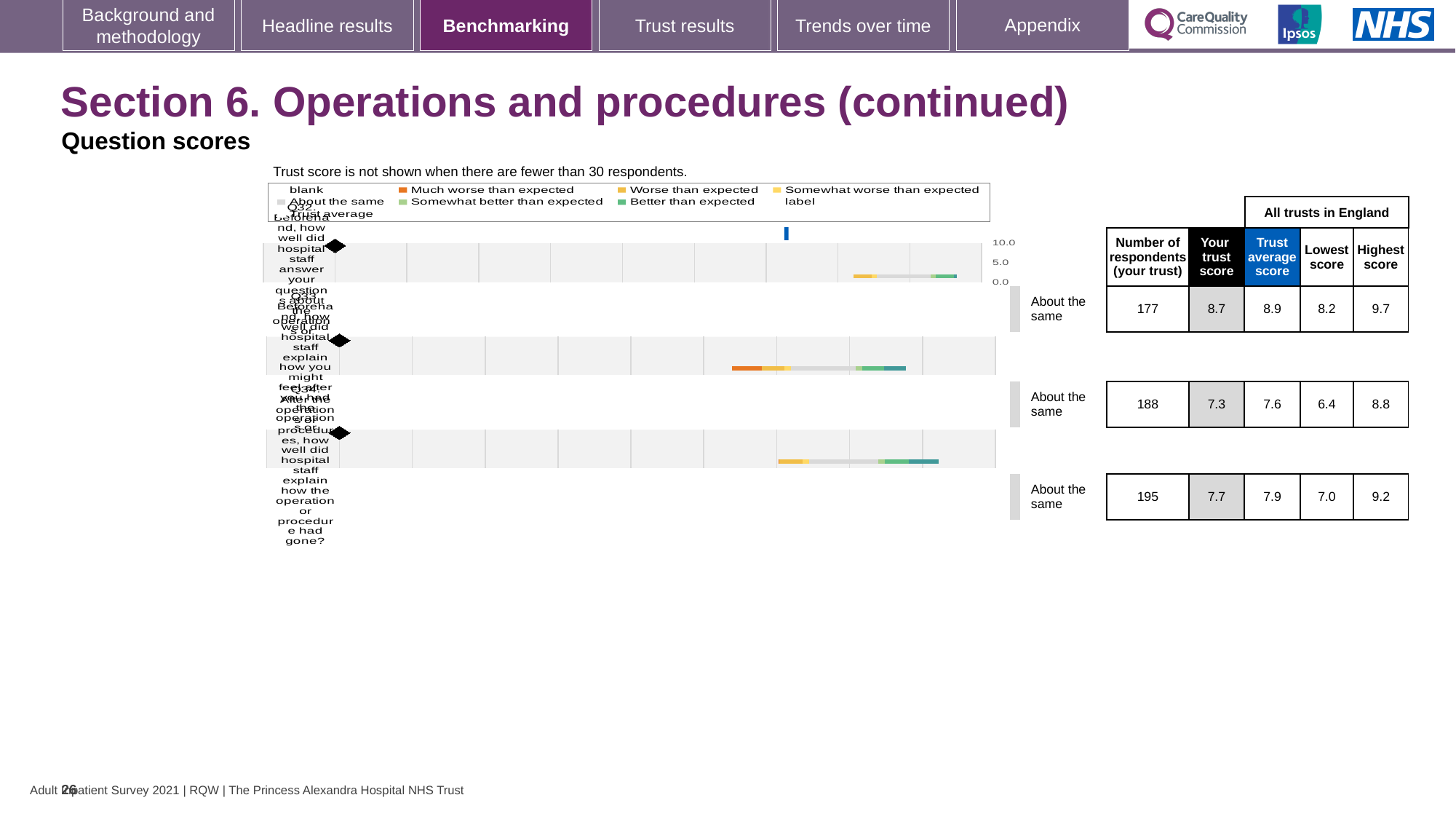
What is the difference between the trust score and the trust average score for the first question row (Q32)? 0.2 How many question rows are plotted in the benchmarking chart? 3 What kind of chart is used to show the question scores? bar chart Which question row has the highest trust score? Q32 Which question row has the lowest trust score? Q33 How many respondents answered the first question row (Q32)? 177 Is the trust score for the second question row (Q33) greater or less than the trust score for the third question row (Q34)? less What is the trust score for the third question row (Q34) in the benchmarking chart? 7.7 What is the trust score for the first question row (Q32) in the benchmarking chart? 8.7 What is the highest score across all trusts in England for the third question row (Q34)? 9.2 What is the trust score for the second question row (Q33) in the benchmarking chart? 7.3 What is the trust average score for the second question row (Q33)? 7.6